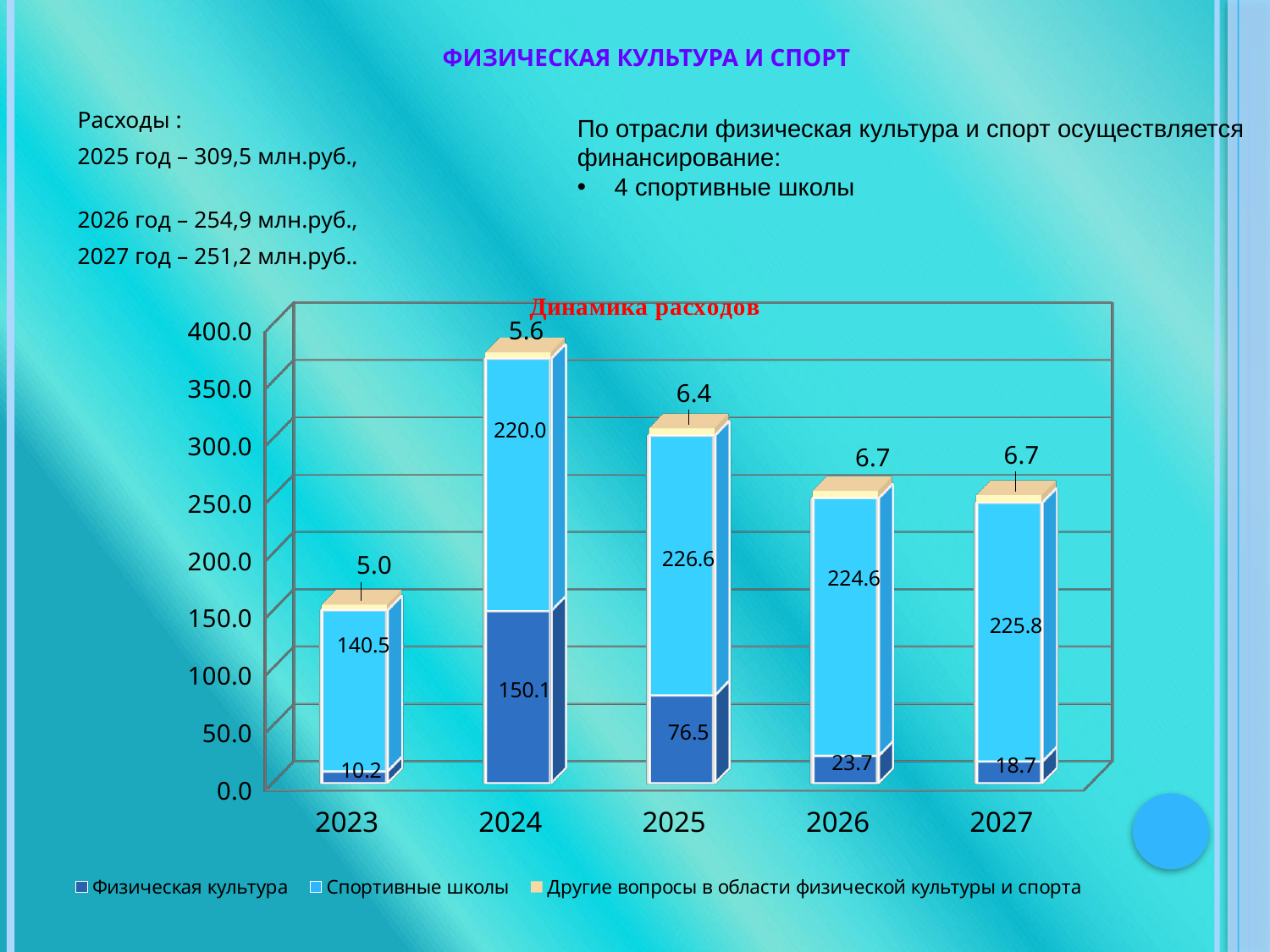
In the chart 'Динамика расходов', what is the difference between the Спортивные школы values for 2025 and 2023? 86.1 In the chart 'Динамика расходов', what is the value for Спортивные школы in 2024? 220.0 What is the title of the chart on the slide? Динамика расходов How many series does the legend of the chart 'Динамика расходов' list? 3 In the chart 'Динамика расходов', what is the value for Физическая культура in 2025? 76.5 In the chart 'Динамика расходов', what is the total of the stacked bar for 2025? 309.5 In the chart 'Динамика расходов', which year has the lowest value for Спортивные школы? 2023 In the chart 'Динамика расходов', which year has the highest value for Физическая культура? 2024 How many years are shown on the x axis of the chart 'Динамика расходов'? 5 What kind of chart is 'Динамика расходов'? Stacked bar chart In the chart 'Динамика расходов', what is the value for Другие вопросы в области физической культуры и спорта in 2027? 6.7 In the chart 'Динамика расходов', which year has the larger value for Физическая культура, 2026 or 2027? 2026